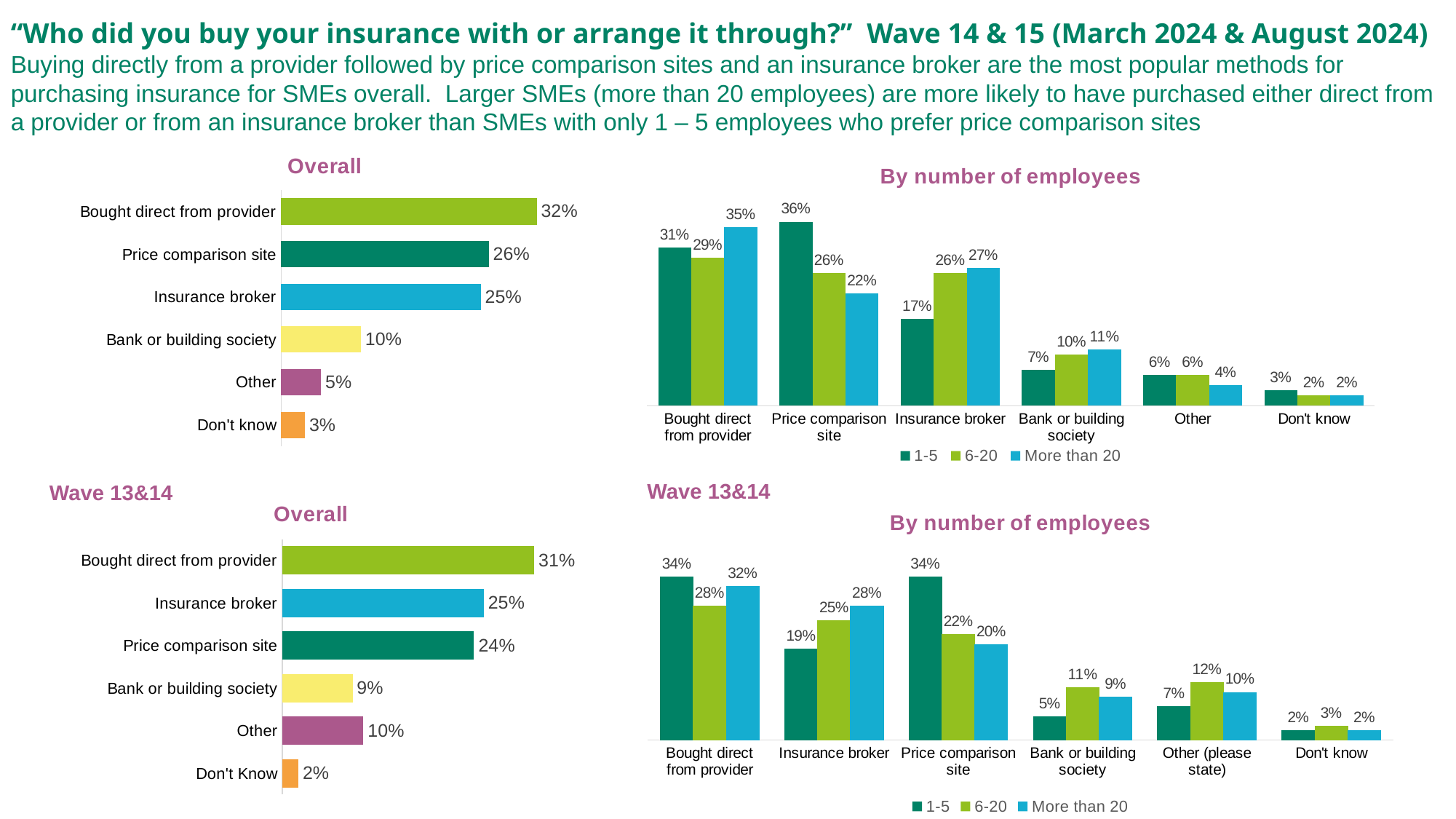
In the top-right 'By number of employees' chart, which series has the highest value for Insurance broker? More than 20 In the bottom-left 'Wave 13&14 Overall' chart, how many categories are shown? 6 What type of chart is the top-left 'Overall' chart? Bar chart In the top-right 'By number of employees' chart, what is the value for Price comparison site for the 1-5 series? 36% In the top-left 'Overall' chart, which category has the lowest value? Don't know In the bottom-right 'Wave 13&14 By number of employees' chart, what is the difference between the 1-5 and 6-20 values for Bought direct from provider? 6% In the bottom-left 'Wave 13&14 Overall' chart, what percentage is shown for Other? 10% In the bottom-right 'Wave 13&14 By number of employees' chart, which is larger for Price comparison site: the 1-5 series or the More than 20 series? 1-5 In the top-left 'Overall' chart, what is the difference between Price comparison site and Insurance broker? 1% In the top-left 'Overall' chart, what percentage bought direct from provider? 32% In the top-right 'By number of employees' chart, how many series does the legend list? 3 In the bottom-right 'Wave 13&14 By number of employees' chart, what is the value for Bank or building society for the 6-20 series? 11%